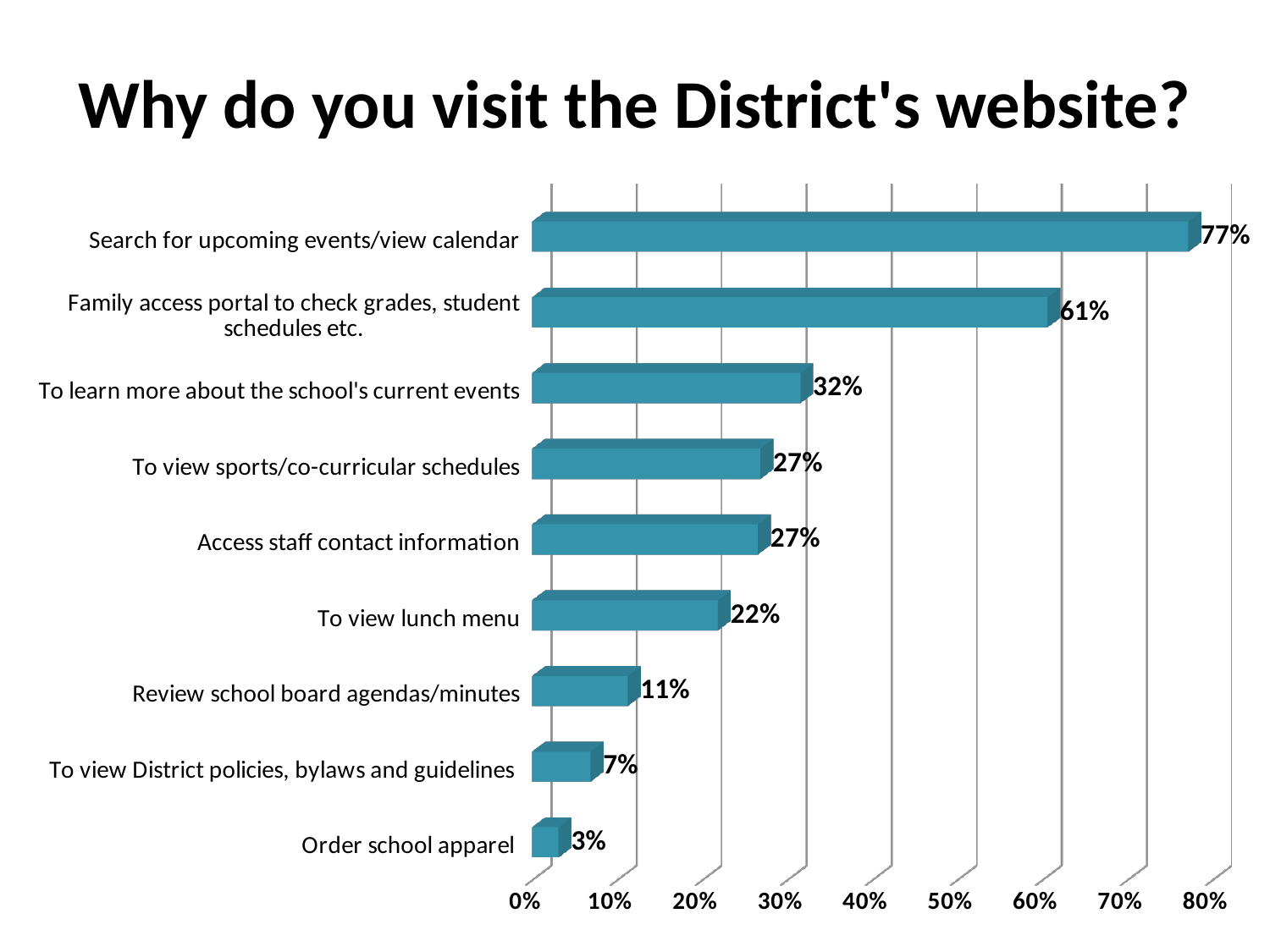
Is the value for 'Family access portal to check grades, student schedules etc.' greater or less than 50%? greater What percentage is shown for 'Review school board agendas/minutes'? 11% Which is larger: the value for 'To learn more about the school's current events' or the value for 'To view lunch menu'? To learn more about the school's current events What is the value for 'To view lunch menu'? 22% What kind of chart is shown on the slide? Bar chart What is the difference between the values for 'To view District policies, bylaws and guidelines' and 'Order school apparel'? 4% What is the difference between the percentage for 'Search for upcoming events/view calendar' and 'Family access portal to check grades, student schedules etc.'? 16% Which reason for visiting the District's website has the highest percentage? Search for upcoming events/view calendar Which reason for visiting the District's website has the lowest percentage? Order school apparel What percentage of respondents visit the District's website to search for upcoming events/view calendar? 77% What is the title of the chart on the slide? Why do you visit the District's website? How many reasons for visiting the District's website are listed in the chart? 9